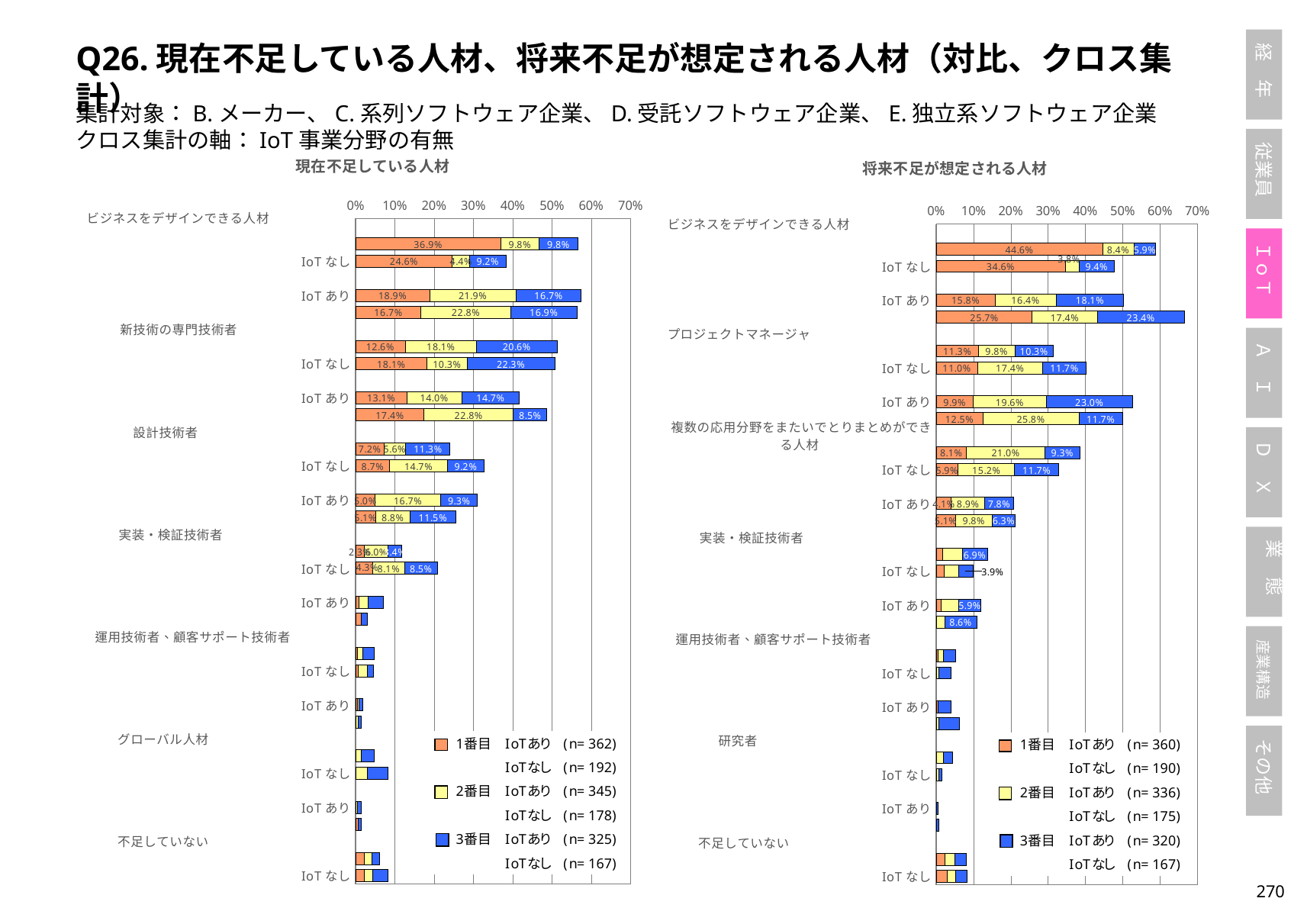
In the right chart (将来不足が想定される人材), what is the 3番目 value for the IoTなし bar of ビジネスをデザインできる人材? 9.4% In the right chart (将来不足が想定される人材), which has the larger 1番目 value for ビジネスをデザインできる人材: IoTあり or IoTなし? IoTあり In the left chart's legend, what is the sample size (n) for 1番目 IoTあり? n= 362 In the left chart (現在不足している人材), is the total of the IoTあり stacked bar for ビジネスをデザインできる人材 greater or less than 50%? greater In the left chart (現在不足している人材), what is the total of the IoTあり stacked bar for ビジネスをデザインできる人材? 56.5% In the right chart (将来不足が想定される人材), what is the 1番目 value for the IoTあり bar of ビジネスをデザインできる人材? 44.6% In the left chart (現在不足している人材), what is the 1番目 value for the IoTあり bar of ビジネスをデザインできる人材? 36.9% In the left chart (現在不足している人材), what is the difference between the 1番目 values of the IoTあり and IoTなし bars for ビジネスをデザインできる人材? 12.3 percentage points In the right chart (将来不足が想定される人材), what is the total of the IoTあり stacked bar for ビジネスをデザインできる人材? 58.9% What is the title of the chart on the right side of the slide? 将来不足が想定される人材 How many series does the legend of the left chart (現在不足している人材) list? 3 What kind of chart is used on the left side of the slide (現在不足している人材)? Stacked bar chart